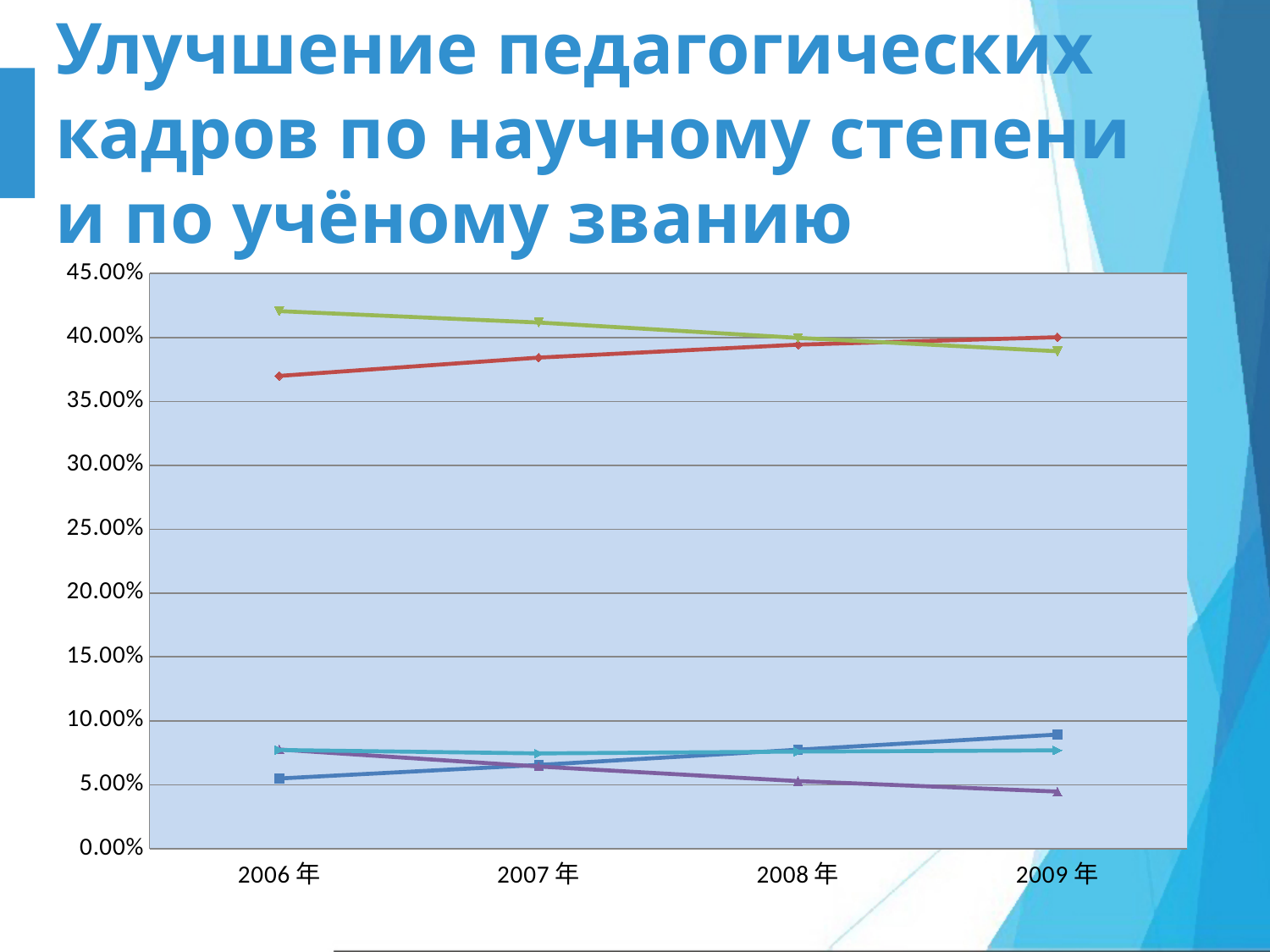
Does the purple line rise or fall from 2006 年 to 2009 年? fall How many years are shown along the x axis of the chart? 4 Is the value of the purple line in 2009 年 greater or less than 5.00%? less What is the first label on the x axis of the chart? 2006 年 Does the red line rise or fall from 2006 年 to 2009 年? rise What is the highest value shown on the y axis of the chart? 45.00% Is the value of the red line in 2006 年 greater or less than 40.00%? less In which year is the purple line at its lowest value? 2009 年 In 2006 年, which line is higher, the green line or the red line? the green line Is the value of the green line in 2006 年 greater or less than 40.00%? greater Does the green line rise or fall from 2006 年 to 2009 年? fall What kind of chart is shown on the slide? line chart